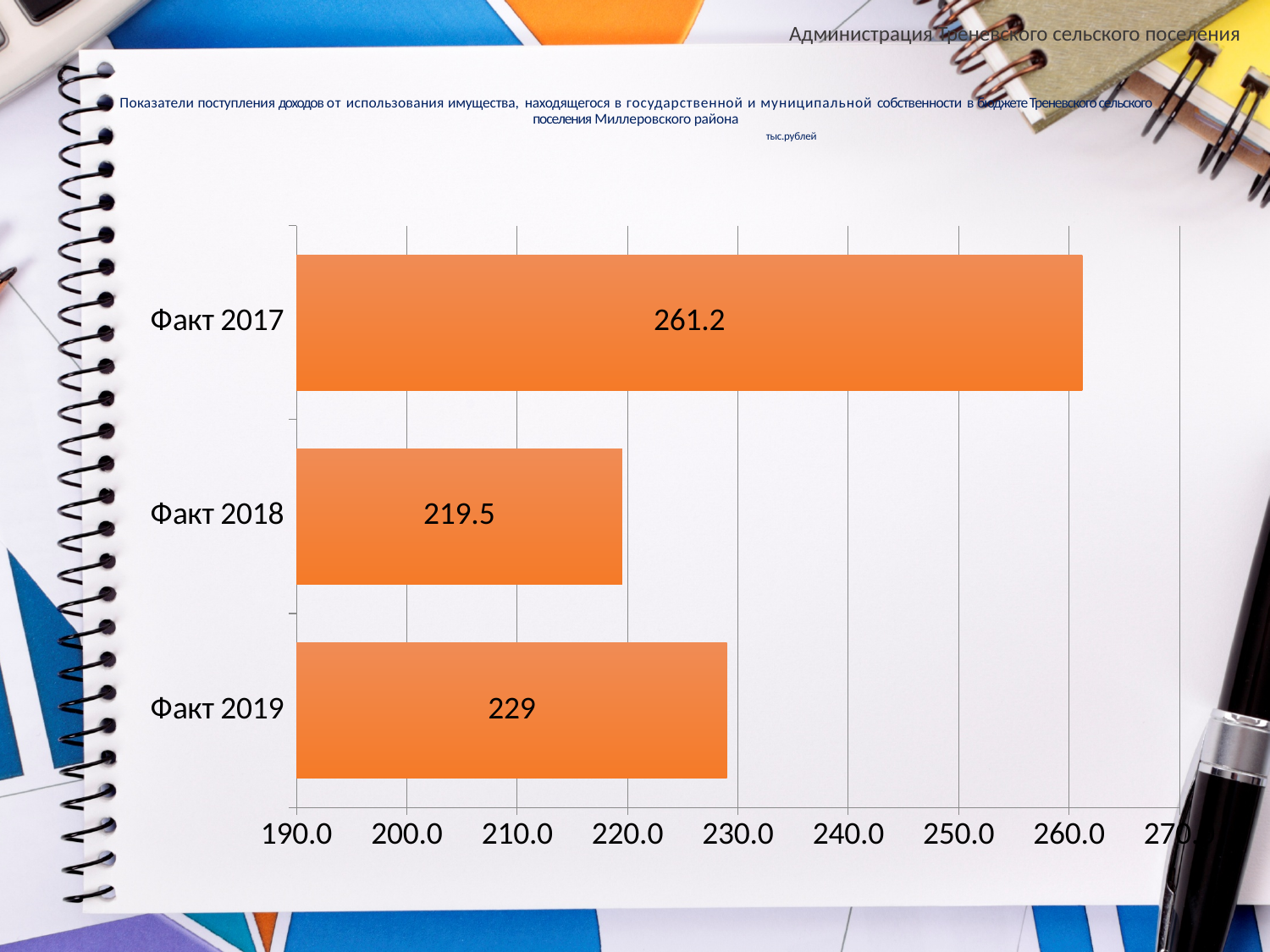
Which category has the highest value? Факт 2017 Which is larger, the value for Факт 2019 or the value for Факт 2018? Факт 2019 What is the difference between the values for Факт 2019 and Факт 2018? 9.5 What is the value for Факт 2019? 229 How many categories are shown in the chart? 3 What is the value for Факт 2017? 261.2 What kind of chart is shown on the slide? bar chart What is the value for Факт 2018? 219.5 Is the value for Факт 2017 greater or less than 250.0? greater Which category has the lowest value? Факт 2018 What unit is stated below the chart title? тыс.рублей What is the difference between the values for Факт 2017 and Факт 2018? 41.7